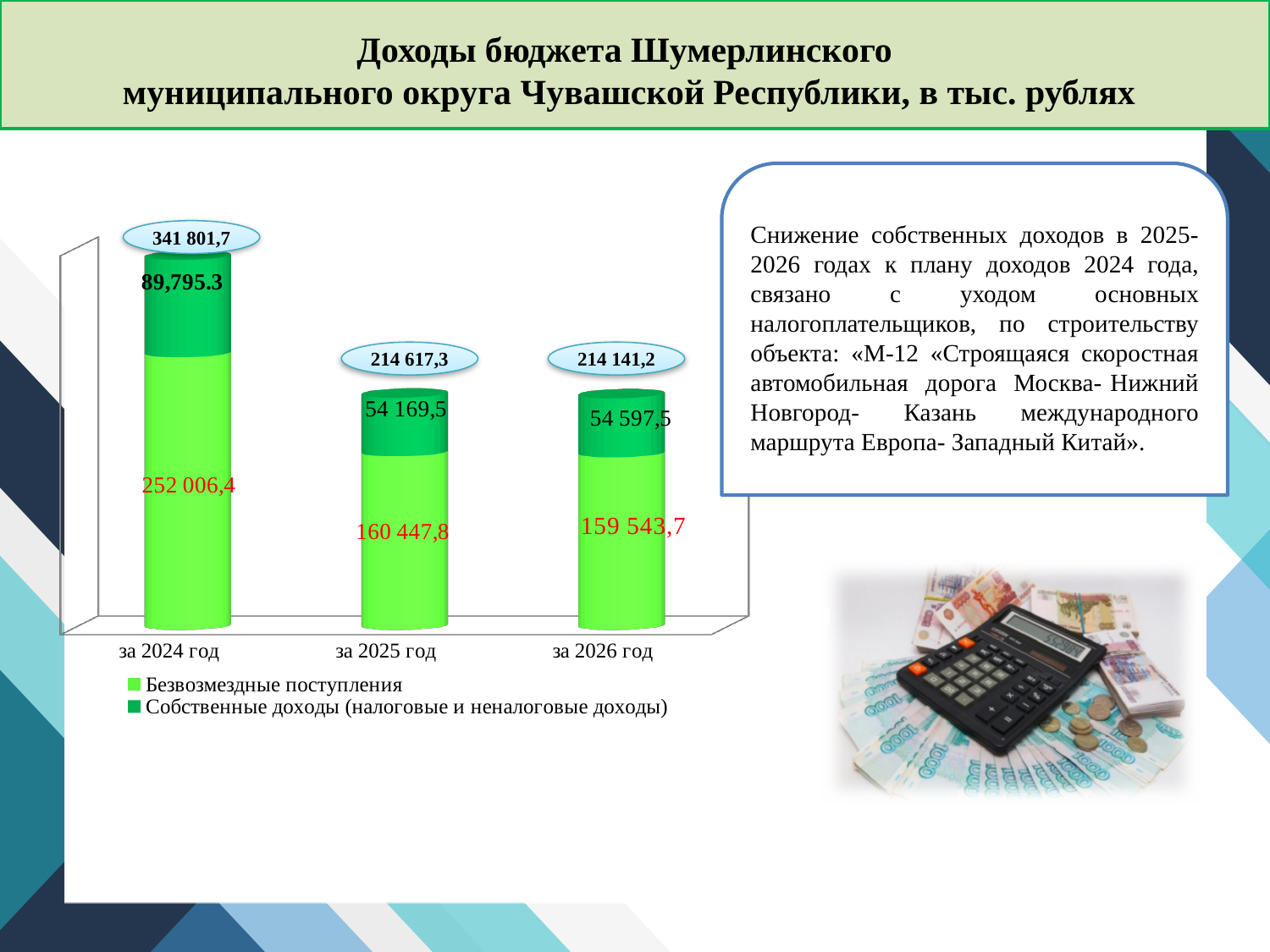
What is the total shown above the bar for за 2025 год? 214 617,3 What type of chart is shown on the slide? bar chart What is the value of Собственные доходы (налоговые и неналоговые доходы) for за 2025 год? 54 169,5 Does the total budget income rise or fall from за 2024 год to за 2026 год? fall What is the value of Собственные доходы (налоговые и неналоговые доходы) for за 2024 год? 89,795.3 How many series does the chart legend list? 2 Which year has the highest total budget income? за 2024 год What is the value of Безвозмездные поступления for за 2024 год? 252 006,4 Which year has the lowest value of Безвозмездные поступления? за 2026 год What is the value of Безвозмездные поступления for за 2026 год? 159 543,7 Which is larger: Собственные доходы for за 2024 год or for за 2026 год? за 2024 год How many categories (years) are shown on the x axis of the chart? 3